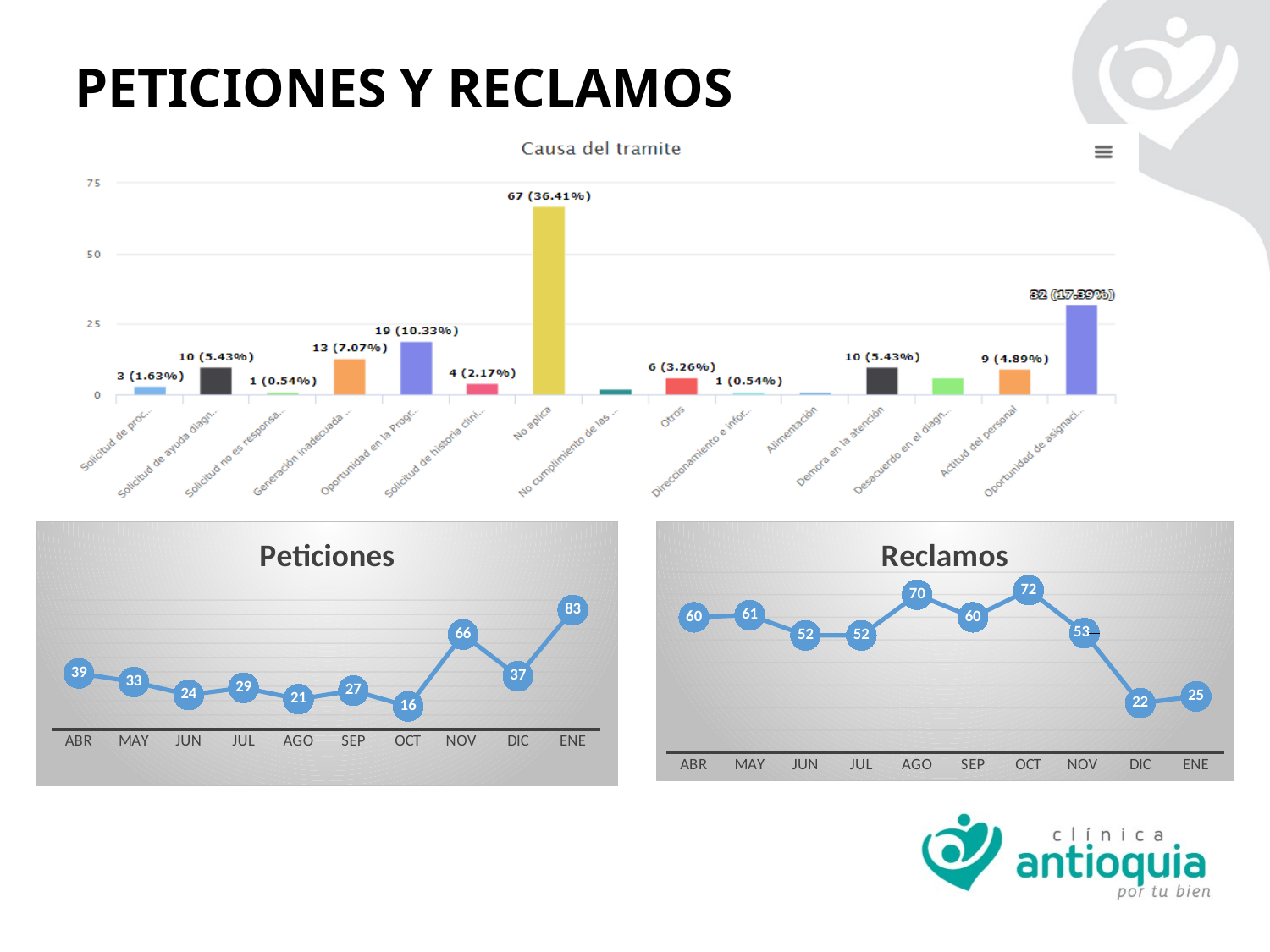
In the Peticiones chart, which month has the lowest value? OCT In the Reclamos chart, what is the value for AGO? 70 In the Reclamos chart, which month has the lowest value? DIC In the Peticiones chart, what is the value for ENE? 83 In the Causa del tramite chart, what is the value shown for No aplica? 67 (36.41%) In the Reclamos chart, is the value for ABR or the value for DIC larger? ABR In the Peticiones chart, how many months are plotted? 10 In the Reclamos chart, what is the difference between the values for NOV and DIC? 31 What kind of chart is the Causa del tramite chart? Bar chart In the Reclamos chart, which month has the highest value? OCT In the Peticiones chart, what is the difference between the values for NOV and OCT? 50 In the Causa del tramite chart, what is the value shown for Demora en la atención? 10 (5.43%)